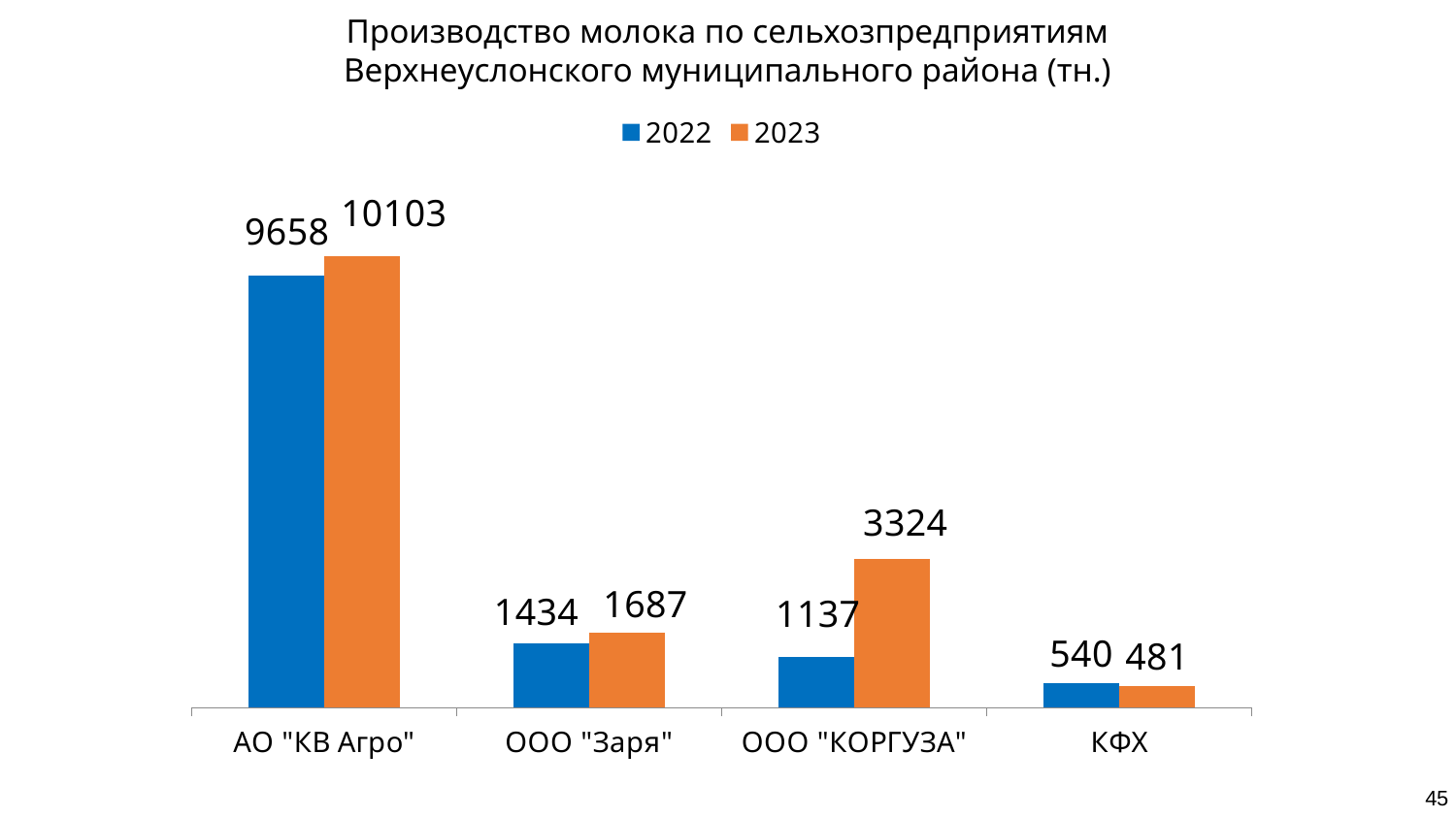
How many enterprises are shown on the chart? 4 What type of chart is shown on the slide? Bar chart How many series does the legend list? 2 What was the milk production of ООО "КОРГУЗА" in 2022? 1137 For КФХ, which year had the higher milk production, 2022 or 2023? 2022 By how much did milk production at ООО "КОРГУЗА" change from 2022 to 2023? 2187 What was the milk production of КФХ in 2023? 481 Which enterprise had the highest milk production in 2023? АО "КВ Агро" Which colour represents the year 2023 in the chart? Orange What was the milk production of АО "КВ Агро" in 2023? 10103 What is the difference between the 2023 and 2022 values for ООО "Заря"? 253 Which enterprise had the lowest milk production in 2022? КФХ